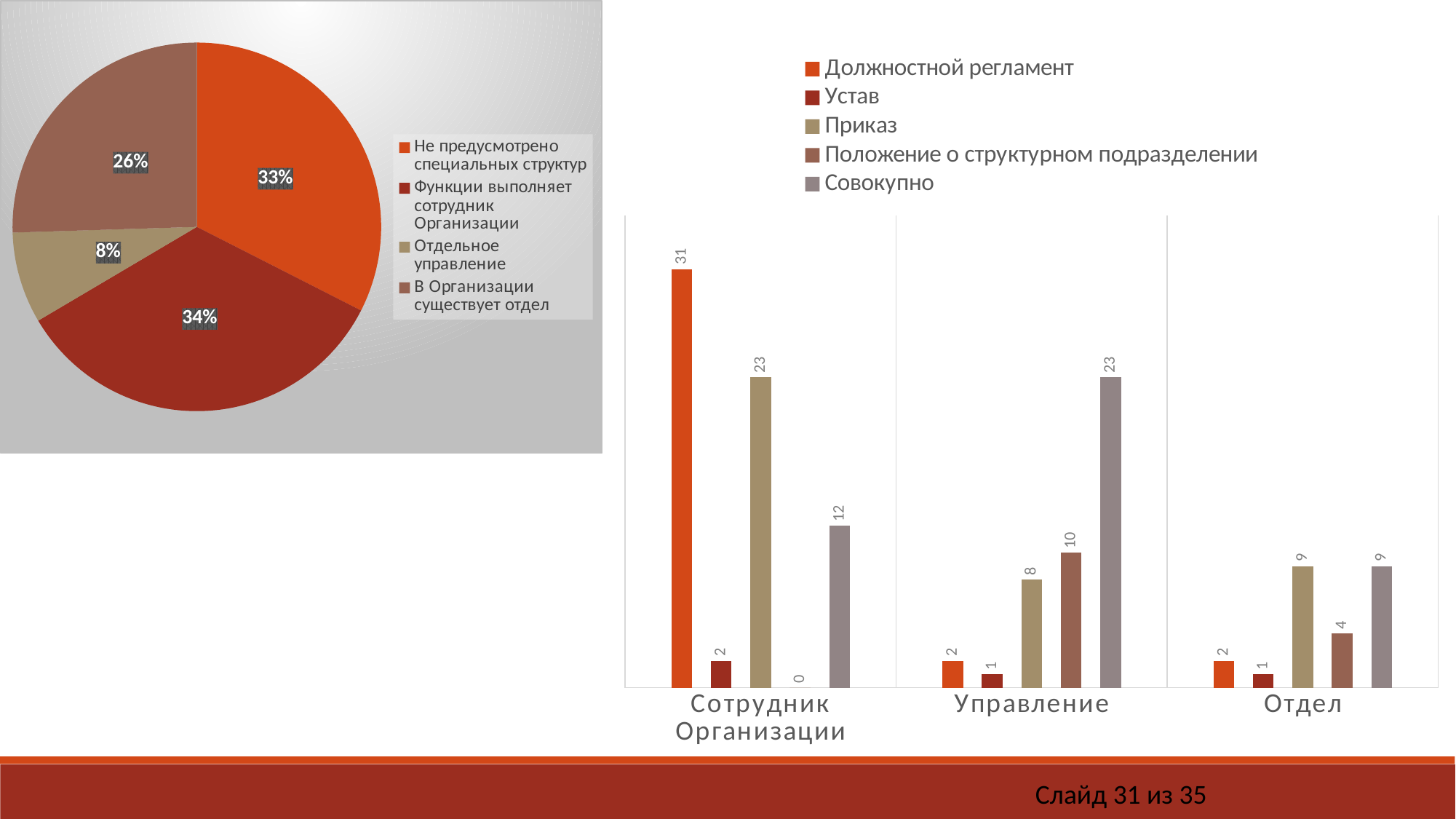
In the pie chart on the left, which slice is the largest? Функции выполняет сотрудник Организации In the pie chart on the left, how many slices are there? 4 In the bar chart on the right, what is the value of 'Положение о структурном подразделении' for 'Отдел'? 4 In the bar chart on the right, which is larger for 'Управление': 'Приказ' or 'Положение о структурном подразделении'? Положение о структурном подразделении In the bar chart on the right, what is the value of 'Должностной регламент' for 'Сотрудник Организации'? 31 What kind of chart is the chart on the right of the slide? bar chart In the pie chart on the left, which slice is the smallest? Отдельное управление In the bar chart on the right, what is the value of 'Совокупно' for 'Управление'? 23 What kind of chart is the chart on the left of the slide? pie chart In the bar chart on the right, what is the difference between 'Приказ' and 'Совокупно' for 'Сотрудник Организации'? 11 In the bar chart on the right, how many series does the legend list? 5 In the pie chart on the left, what share does 'Отдельное управление' have? 8%